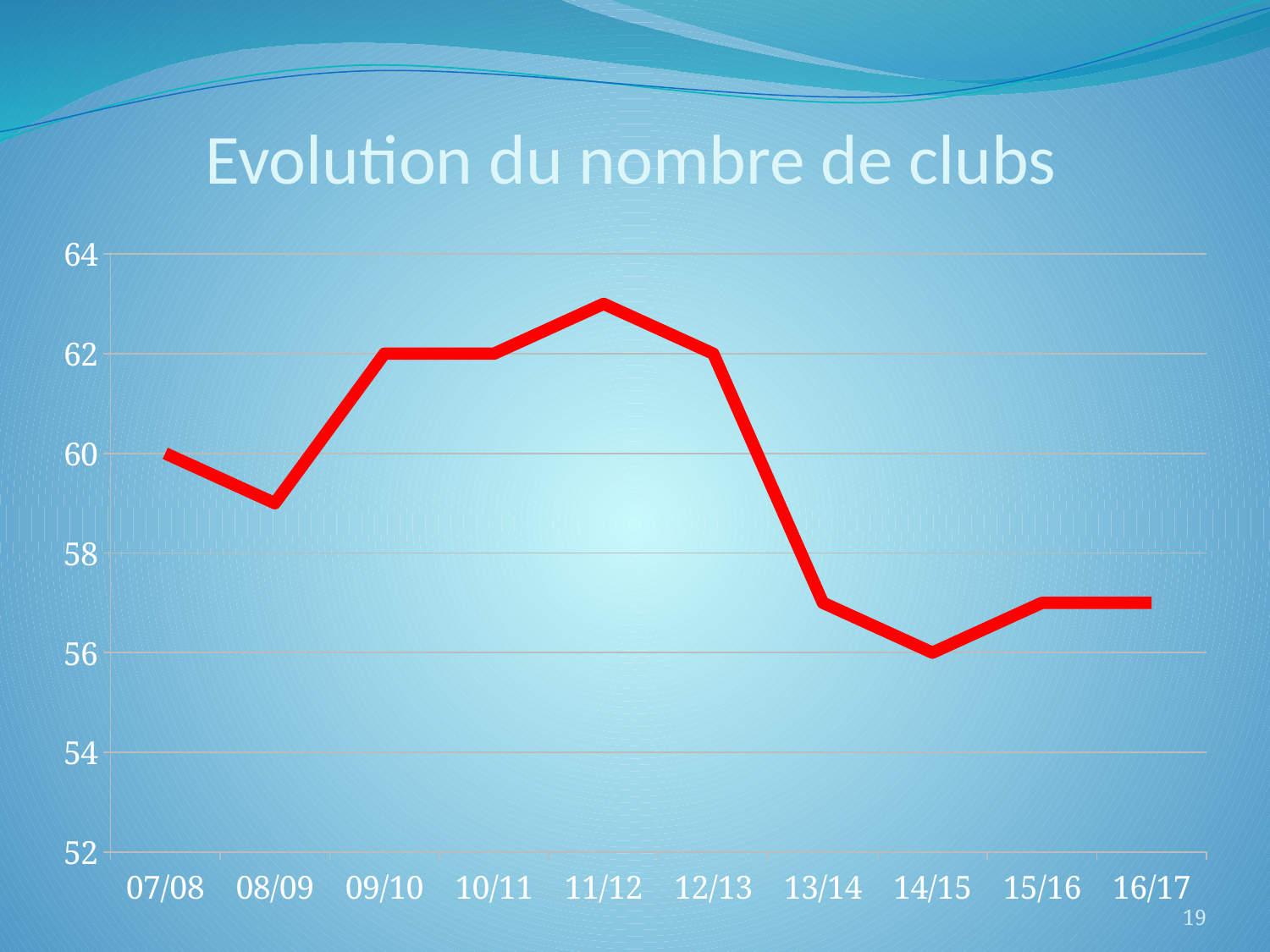
What is the title of the chart? Evolution du nombre de clubs What type of chart is shown on the slide? line chart Which season has the highest number of clubs? 11/12 What is the difference between the values for 09/10 and 14/15? 6 How many seasons are plotted along the x axis? 10 Is the value for 11/12 greater or less than 62? greater What is the value for 09/10? 62 Which season has the lowest number of clubs? 14/15 Which is larger, the value for 10/11 or the value for 15/16? 10/11 Is the value for 13/14 greater or less than 58? less What is the value for 07/08? 60 What is the value for 14/15? 56